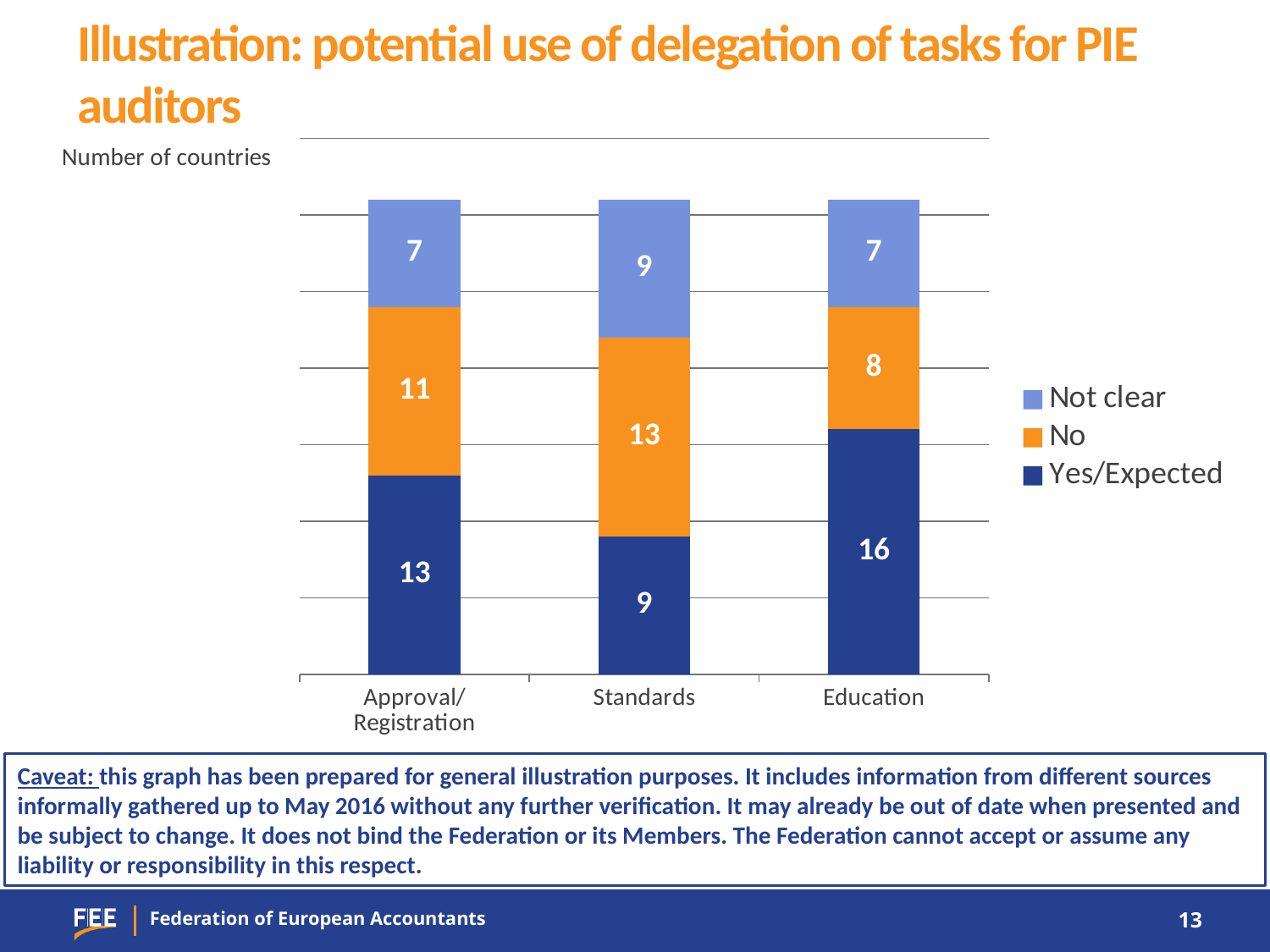
Which is larger, the No value for Approval/Registration or the No value for Standards? Standards What is the Not clear value for Approval/Registration? 7 Which category has the highest Yes/Expected value? Education What kind of chart is shown on the slide? Stacked bar chart What is the Yes/Expected value for Education? 16 Which category has the lowest No value? Education What is the difference between the Yes/Expected values for Education and Standards? 7 What is the total of the stacked bar for Standards? 31 What label appears above the chart to describe the values? Number of countries How many categories are shown on the x axis? 3 How many series does the legend list? 3 What is the No value for Standards? 13